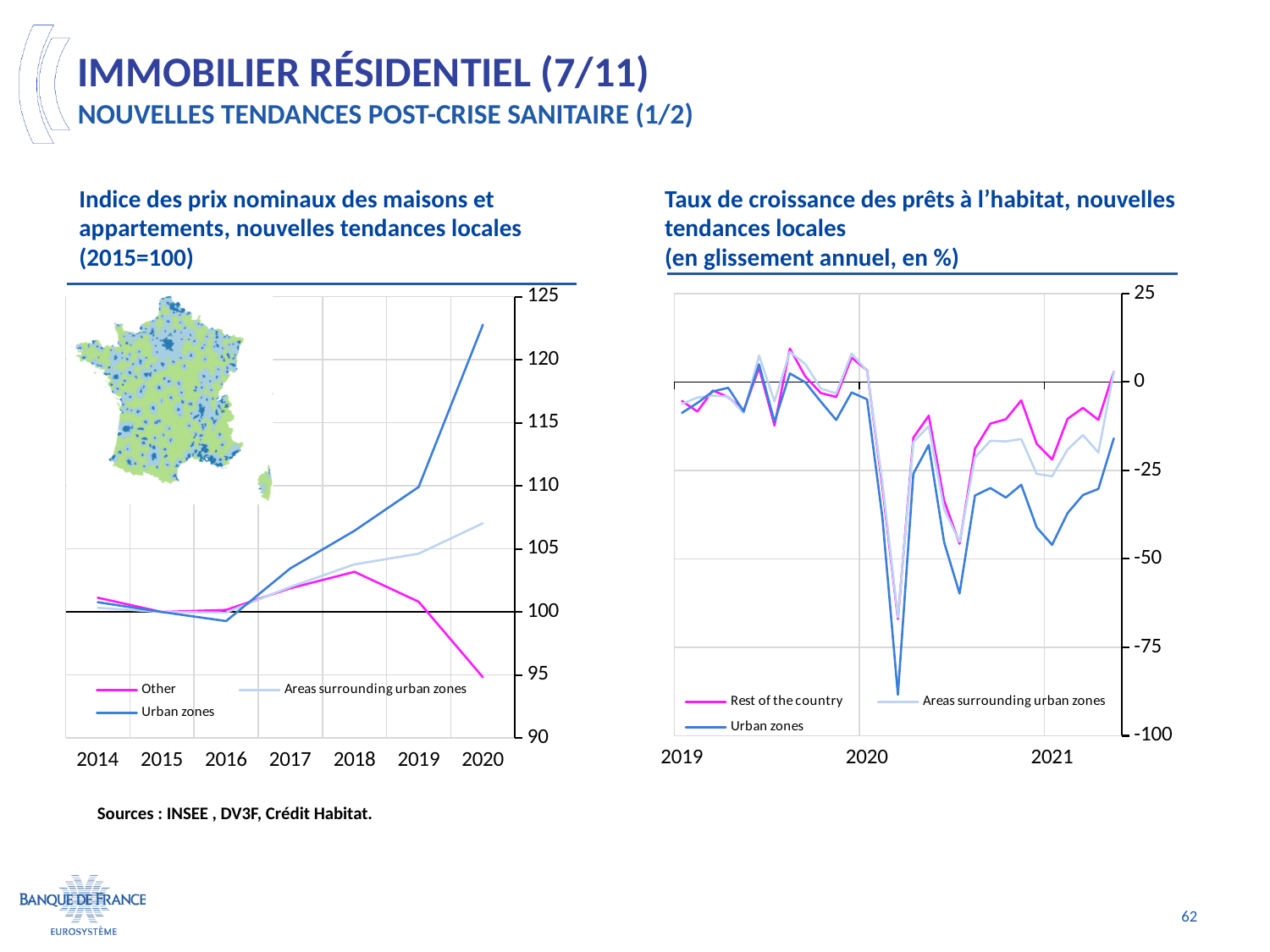
In the left chart, 'Indice des prix nominaux des maisons et appartements', does the Urban zones series rise or fall between 2016 and 2020? Rise What kind of chart is the left chart, 'Indice des prix nominaux des maisons et appartements'? Line chart In the left chart, 'Indice des prix nominaux des maisons et appartements', which series has the highest value in 2020? Urban zones In the left chart, 'Indice des prix nominaux des maisons et appartements', is the value for Urban zones in 2020 greater or less than 120? greater In the right chart, 'Taux de croissance des prêts à l'habitat', which series reaches the lowest value during 2020? Urban zones In the left chart, 'Indice des prix nominaux des maisons et appartements', which series has the lowest value in 2020? Other In the right chart, 'Taux de croissance des prêts à l'habitat', is the lowest value of the Urban zones series greater or less than -75? less How many series does the legend of the left chart, 'Indice des prix nominaux des maisons et appartements', list? 3 What kind of chart is the right chart, 'Taux de croissance des prêts à l'habitat'? Line chart In the left chart, 'Indice des prix nominaux des maisons et appartements', is the value for Other in 2020 greater or less than 100? less In the left chart, 'Indice des prix nominaux des maisons et appartements', which is larger in 2020: Areas surrounding urban zones or Other? Areas surrounding urban zones How many series does the legend of the right chart, 'Taux de croissance des prêts à l'habitat', list? 3